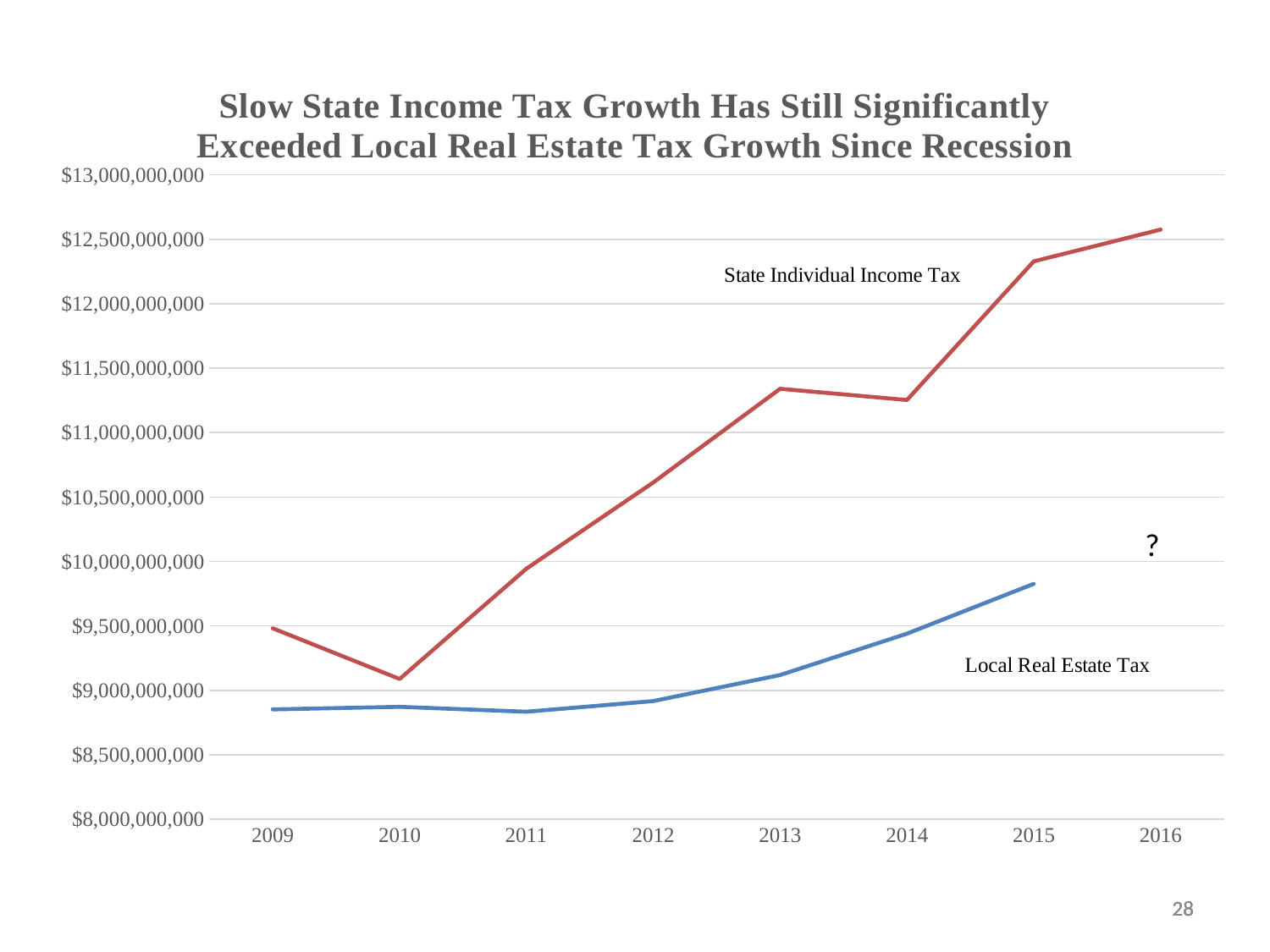
What colour is the State Individual Income Tax line? red Which is larger in 2014, State Individual Income Tax or Local Real Estate Tax? State Individual Income Tax How many years are shown on the x axis? 8 In which year is the State Individual Income Tax line at its highest? 2016 Does the Local Real Estate Tax line rise or fall from 2012 to 2015? rise In which year is the State Individual Income Tax line at its lowest? 2010 Is the State Individual Income Tax value for 2016 greater or less than $12,000,000,000? greater Is the Local Real Estate Tax value for 2015 greater or less than $10,000,000,000? less Is the State Individual Income Tax value for 2010 greater or less than $9,500,000,000? less In which year is the Local Real Estate Tax line at its highest? 2015 How many data series are plotted on the chart? 2 What kind of chart is shown on the slide? line chart